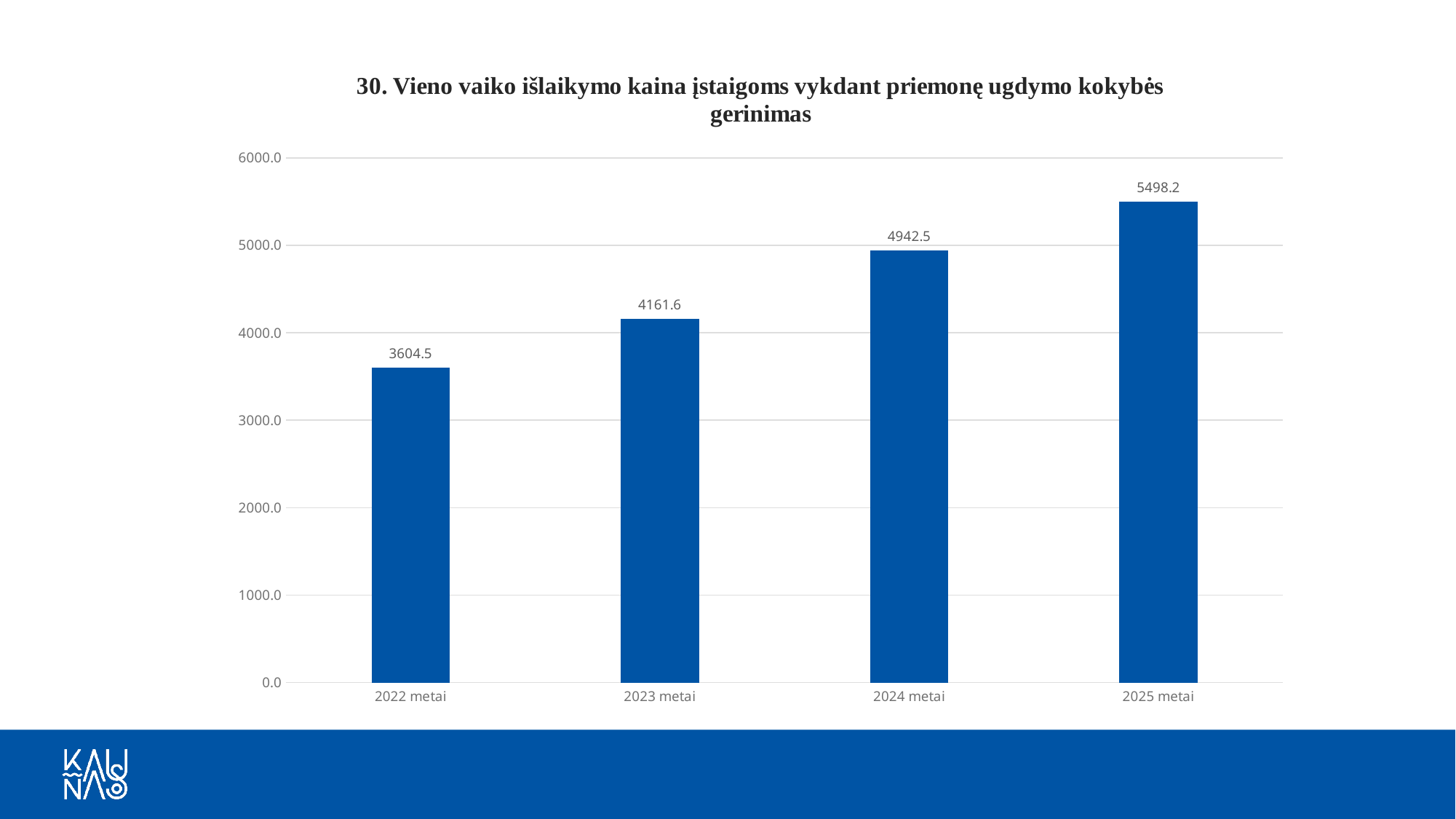
What is the value for 2023 metai? 4161.6 What is the value for 2024 metai? 4942.5 Which is larger, the value for 2023 metai or the value for 2024 metai? 2024 metai What is the value for 2025 metai? 5498.2 Do the values rise or fall from 2022 metai to 2025 metai? rise What is the value for 2022 metai? 3604.5 Which year has the highest value? 2025 metai How many years are shown on the x axis? 4 Which year has the lowest value? 2022 metai What kind of chart is this? bar chart What is the difference between the values for 2025 metai and 2024 metai? 555.7 What is the difference between the values for 2023 metai and 2022 metai? 557.1